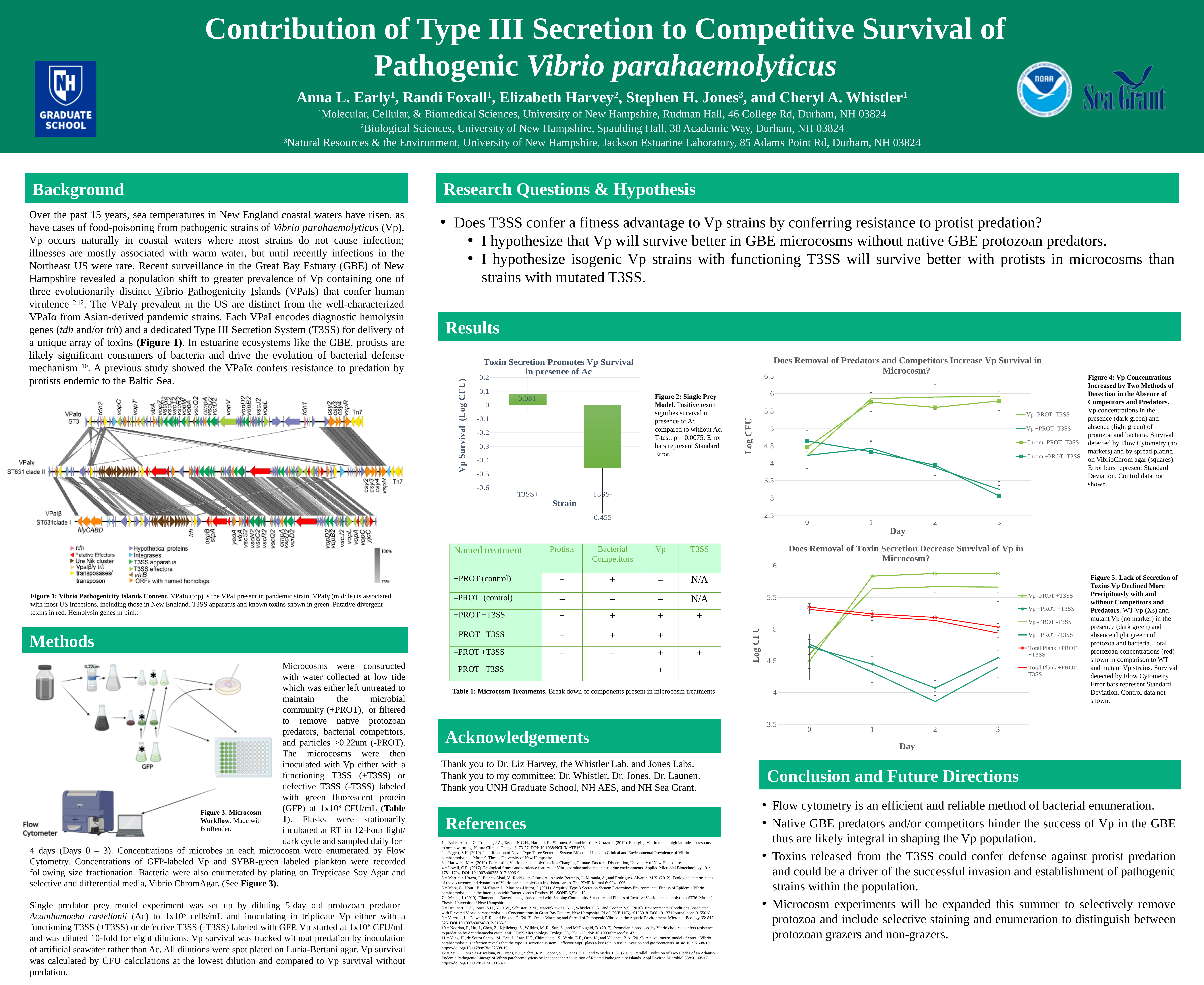
In the chart titled 'Does Removal of Toxin Secretion Decrease Survival of Vp in Microcosm?', which is larger at Day 3: Vp -PROT +T3SS or Vp +PROT +T3SS? Vp -PROT +T3SS In the chart titled 'Toxin Secretion Promotes Vp Survival in presence of Ac', what is the Vp survival value for the T3SS- strain? -0.455 In the chart titled 'Does Removal of Toxin Secretion Decrease Survival of Vp in Microcosm?', is the value for Vp +PROT +T3SS at Day 2 greater or less than 4.5? less In the chart titled 'Toxin Secretion Promotes Vp Survival in presence of Ac', what is the Vp survival value for the T3SS+ strain? 0.081 How many series does the legend list in the chart titled 'Does Removal of Toxin Secretion Decrease Survival of Vp in Microcosm?'? 6 What kind of chart is 'Toxin Secretion Promotes Vp Survival in presence of Ac'? Bar chart In the chart titled 'Does Removal of Predators and Competitors Increase Vp Survival in Microcosm?', does the Vp +PROT -T3SS series rise or fall from Day 0 to Day 3? fall In the chart titled 'Does Removal of Predators and Competitors Increase Vp Survival in Microcosm?', is the value for Chrom -PROT -T3SS at Day 3 greater or less than 5.5? greater In the chart titled 'Toxin Secretion Promotes Vp Survival in presence of Ac', what is the x-axis title? Strain In the chart titled 'Toxin Secretion Promotes Vp Survival in presence of Ac', which strain has the higher Vp survival value? T3SS+ How many series does the legend list in the chart titled 'Does Removal of Predators and Competitors Increase Vp Survival in Microcosm?'? 4 In the chart titled 'Toxin Secretion Promotes Vp Survival in presence of Ac', what is the difference between the T3SS+ and T3SS- values? 0.536